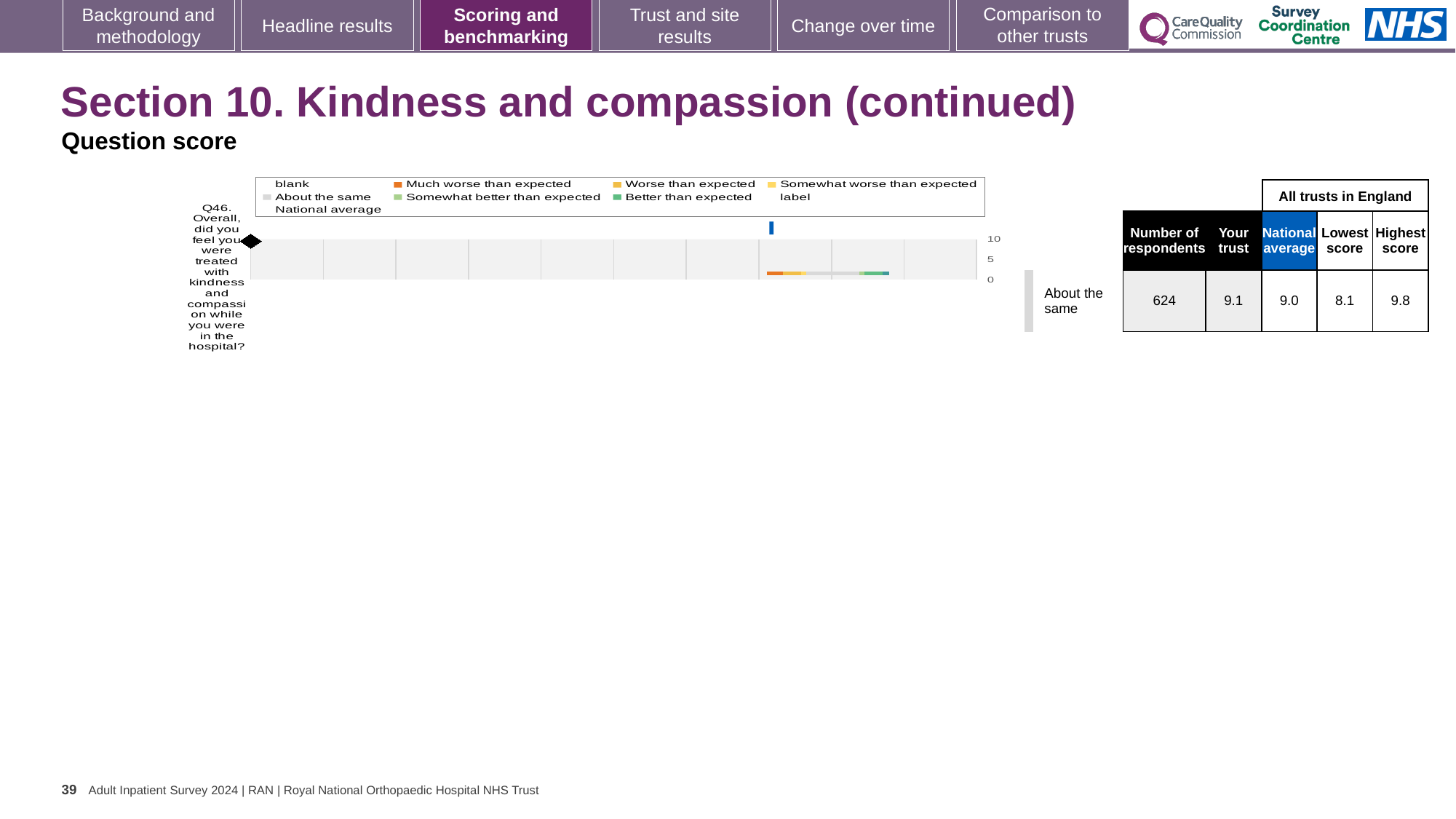
What is the national average score for Q46 shown in the table? 9.0 Which is larger for Q46: the trust's score or the national average? Your trust Is the trust's score for Q46 greater or less than 5 on the chart's axis? greater What is the lowest score among all trusts in England for Q46? 8.1 How many respondents answered Q46? 624 What is the difference between the highest and lowest scores for Q46 across all trusts in England? 1.7 What is the 'Your trust' score for Q46 shown in the table next to the chart? 9.1 What benchmarking category is the trust's Q46 score assigned to on the slide? About the same What is the highest score among all trusts in England for Q46? 9.8 What kind of chart is shown on the slide? bar chart How many questions (categories) are plotted on the chart? 1 What is the difference between the trust's score and the national average for Q46? 0.1